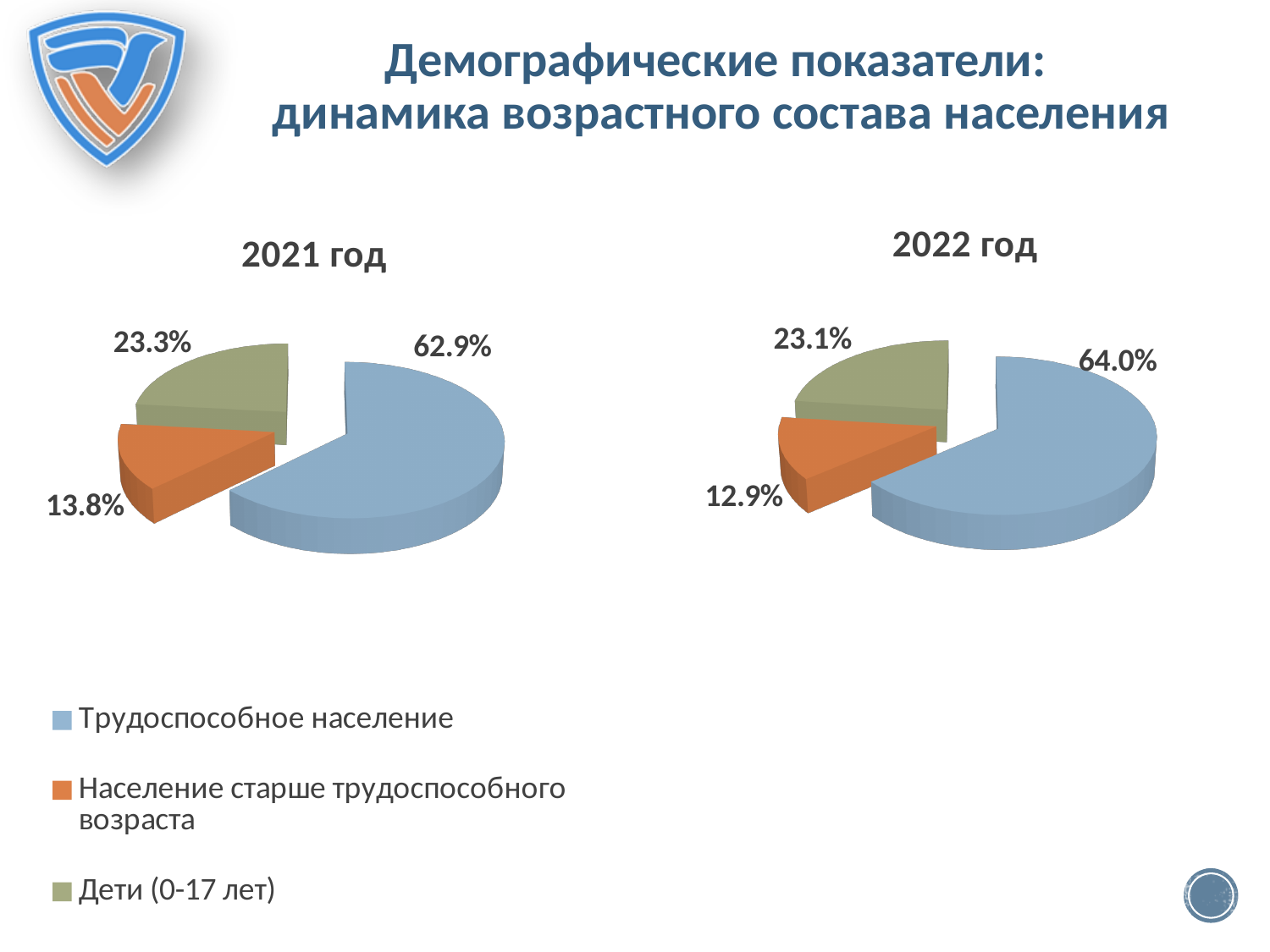
In the "2022 год" chart, what share is shown for Население старше трудоспособного возраста? 12.9% In the "2021 год" chart, which category has the largest slice? Трудоспособное население In the "2022 год" chart, which category has the smallest slice? Население старше трудоспособного возраста In the "2021 год" chart, which category has the smallest slice? Население старше трудоспособного возраста What is the difference between the Дети (0-17 лет) share in the "2021 год" chart and in the "2022 год" chart? 0.2% How many slices does the "2022 год" pie chart have? 3 What is the difference between the Трудоспособное население share in the "2022 год" chart and in the "2021 год" chart? 1.1% Which colour represents Дети (0-17 лет) in the legend? Green Is the Население старше трудоспособного возраста share larger in the "2021 год" chart or the "2022 год" chart? 2021 год What type of chart is the "2021 год" chart? Pie chart In the "2021 год" chart, what share is shown for Трудоспособное население? 62.9% In the "2022 год" chart, what share is shown for Дети (0-17 лет)? 23.1%